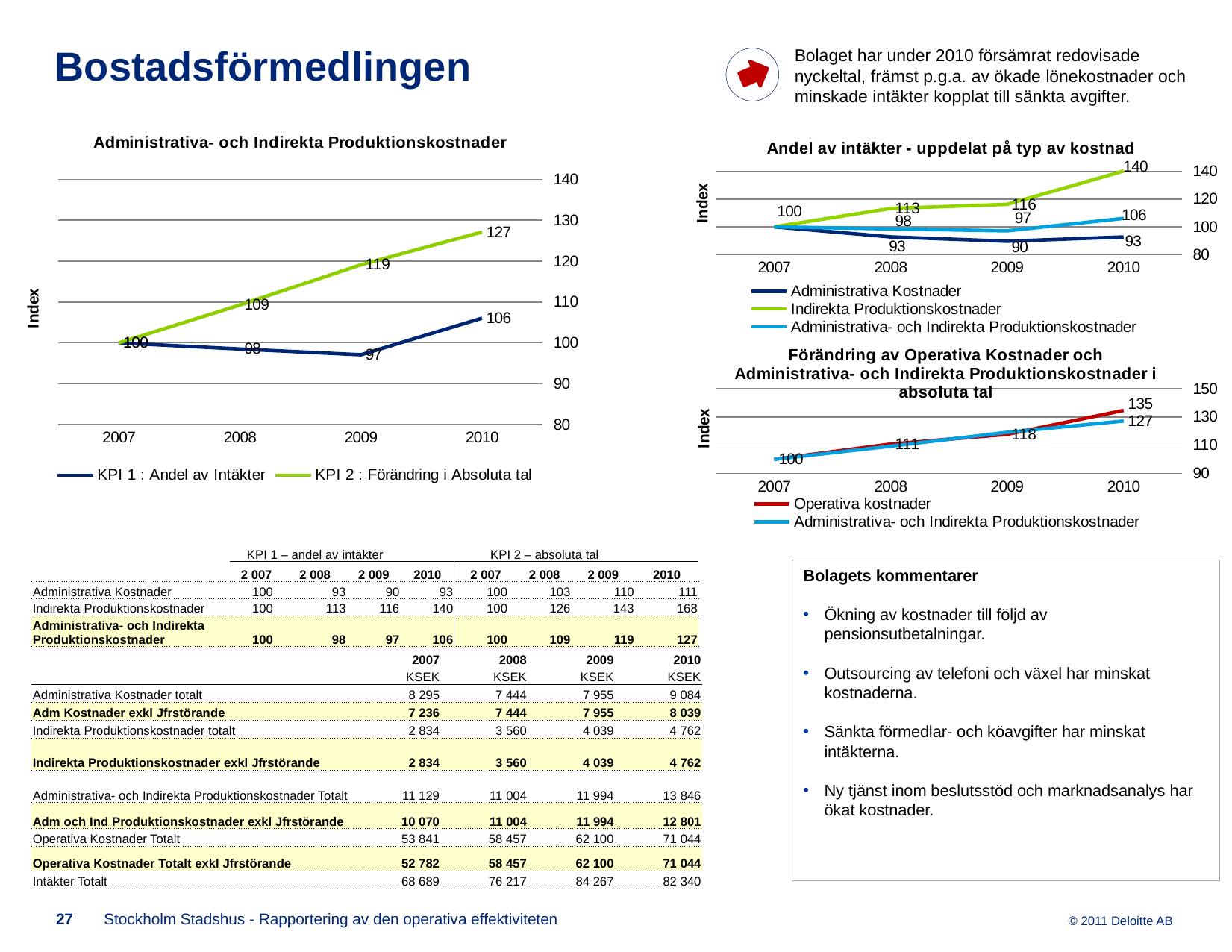
In the chart titled 'Administrativa- och Indirekta Produktionskostnader', what is the value of KPI 1 : Andel av Intäkter in 2009? 97 In the chart titled 'Administrativa- och Indirekta Produktionskostnader', how many series does the legend list? 2 In the chart titled 'Administrativa- och Indirekta Produktionskostnader', does KPI 2 : Förändring i Absoluta tal rise or fall from 2007 to 2010? rise What type of chart is the chart titled 'Administrativa- och Indirekta Produktionskostnader'? line chart In the chart titled 'Andel av intäkter - uppdelat på typ av kostnad', what is the value of Indirekta Produktionskostnader in 2010? 140 In the chart titled 'Andel av intäkter - uppdelat på typ av kostnad', in which year is Administrativa Kostnader lowest? 2009 In the chart titled 'Andel av intäkter - uppdelat på typ av kostnad', which is larger in 2008: Indirekta Produktionskostnader or Administrativa Kostnader? Indirekta Produktionskostnader In the chart titled 'Administrativa- och Indirekta Produktionskostnader', what is the difference between KPI 2 and KPI 1 in 2010? 21 In the bottom-right chart ('Förändring av Operativa Kostnader ...'), what is the value of Operativa kostnader in 2010? 135 In the chart titled 'Administrativa- och Indirekta Produktionskostnader', what is the value of KPI 2 : Förändring i Absoluta tal in 2010? 127 In the chart titled 'Andel av intäkter - uppdelat på typ av kostnad', how many series does the legend list? 3 In the bottom-right chart ('Förändring av Operativa Kostnader ...'), what is the difference between Operativa kostnader and Administrativa- och Indirekta Produktionskostnader in 2010? 8